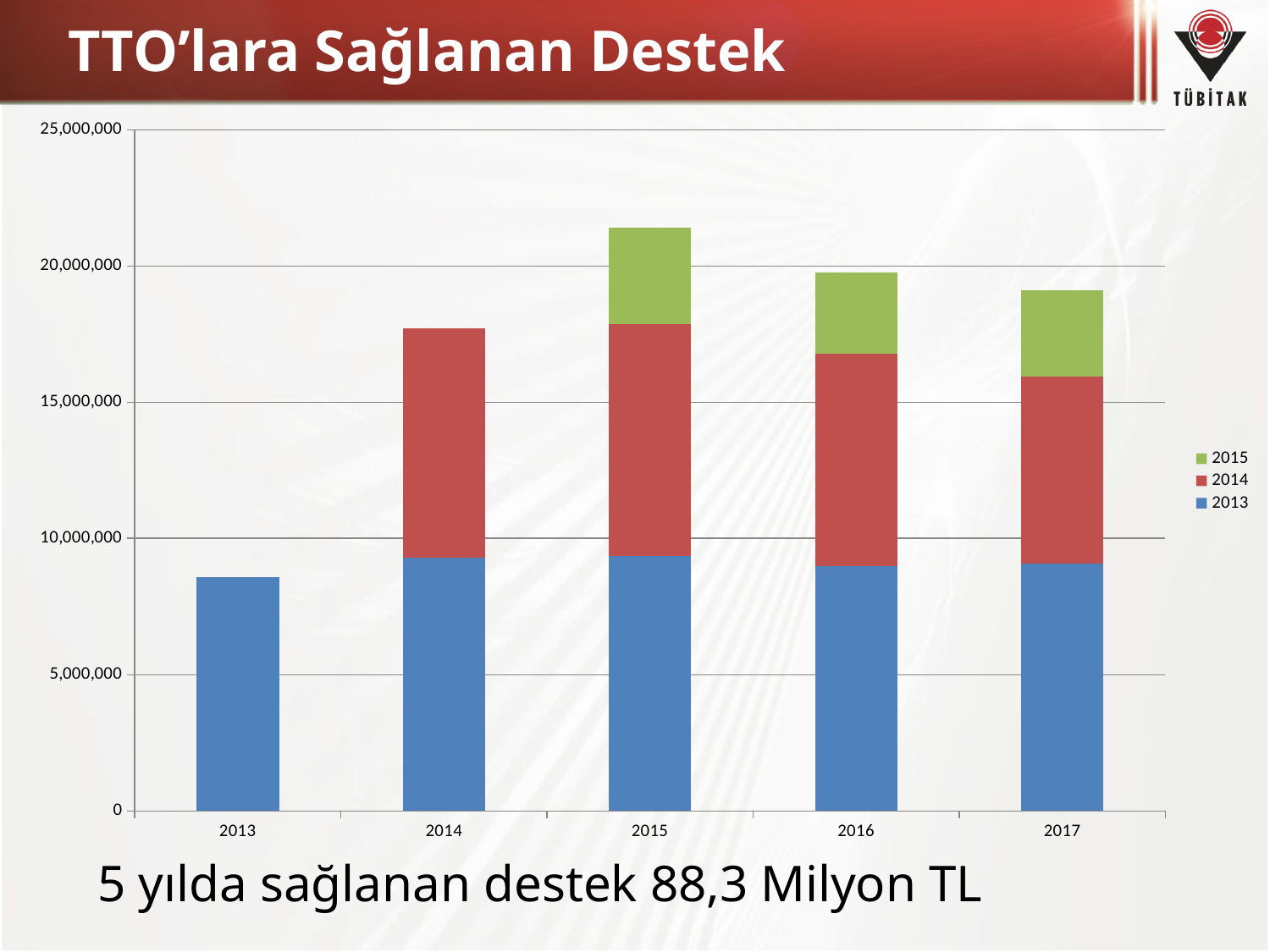
Is the total bar for 2015 greater or less than 20,000,000? greater What is the title of the slide containing the chart? TTO'lara Sağlanan Destek Which has the larger total bar, 2014 or 2015? 2015 Which has the larger total bar, 2013 or 2014? 2014 Which series is shown in green in the chart's legend? 2015 How many series does the chart's legend list? 3 Is the total bar for 2013 greater or less than 10,000,000? less Which year has the tallest stacked bar in the chart? 2015 How many years are shown along the x axis of the chart? 5 Which year has the shortest stacked bar in the chart? 2013 Is the total bar for 2014 greater or less than 15,000,000? greater What kind of chart is shown on the slide? Stacked bar chart